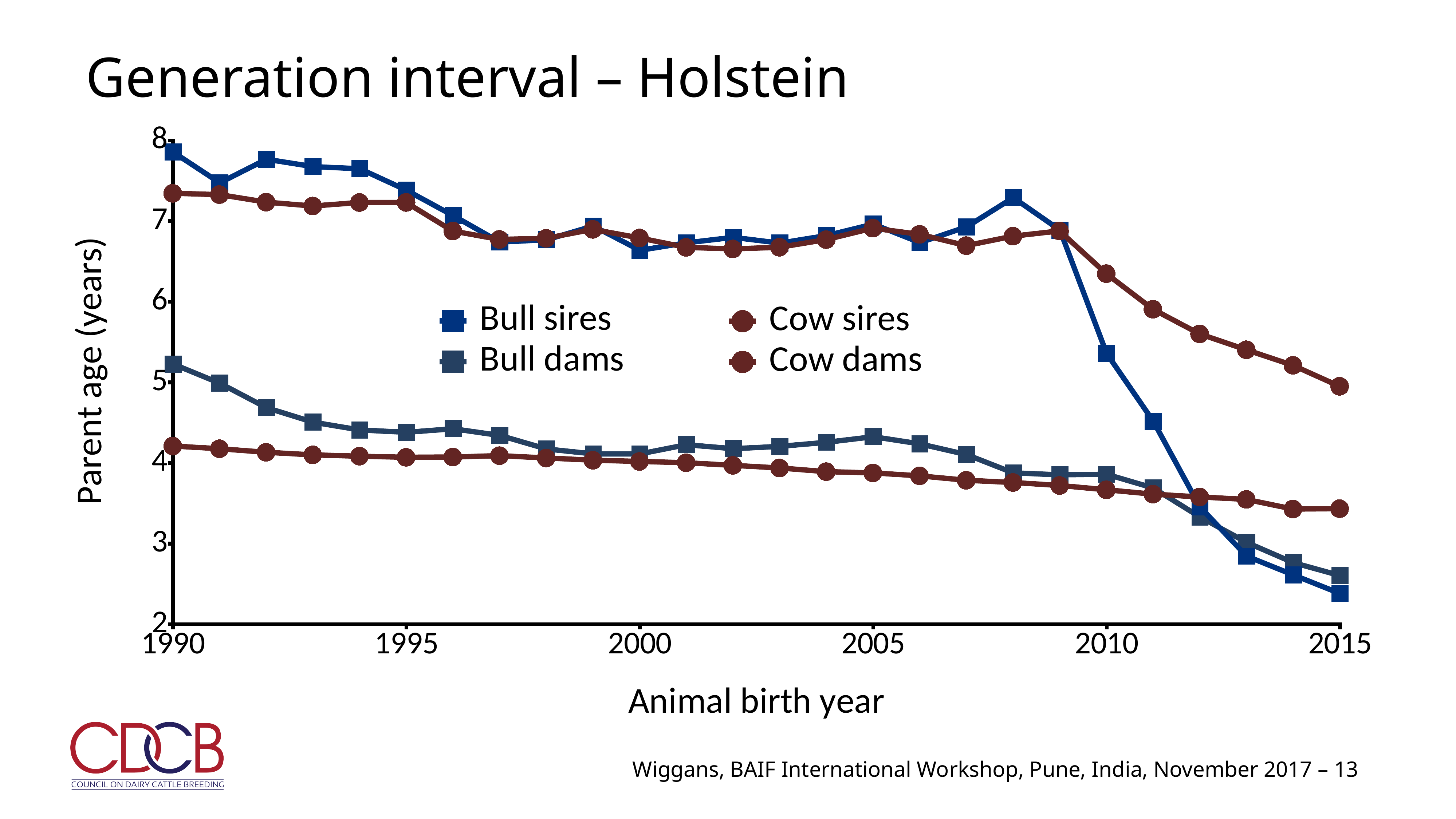
Is the value for Cow dams in 2015 greater or less than 4? less In 1990, which is larger: the value for Bull sires or the value for Cow sires? Bull sires Which series has the highest value in 2015? Cow sires How many series does the legend list? 4 Is the value for Cow sires in 2015 greater or less than 4? greater What is the label of the vertical axis? Parent age (years) Which series has the lowest value in 1990? Cow dams Is the value for Bull sires in 2015 greater or less than 3? less Do the values for Bull sires rise or fall from 2009 to 2015? fall What kind of chart is shown on the slide? line chart What is the title of the chart? Generation interval – Holstein